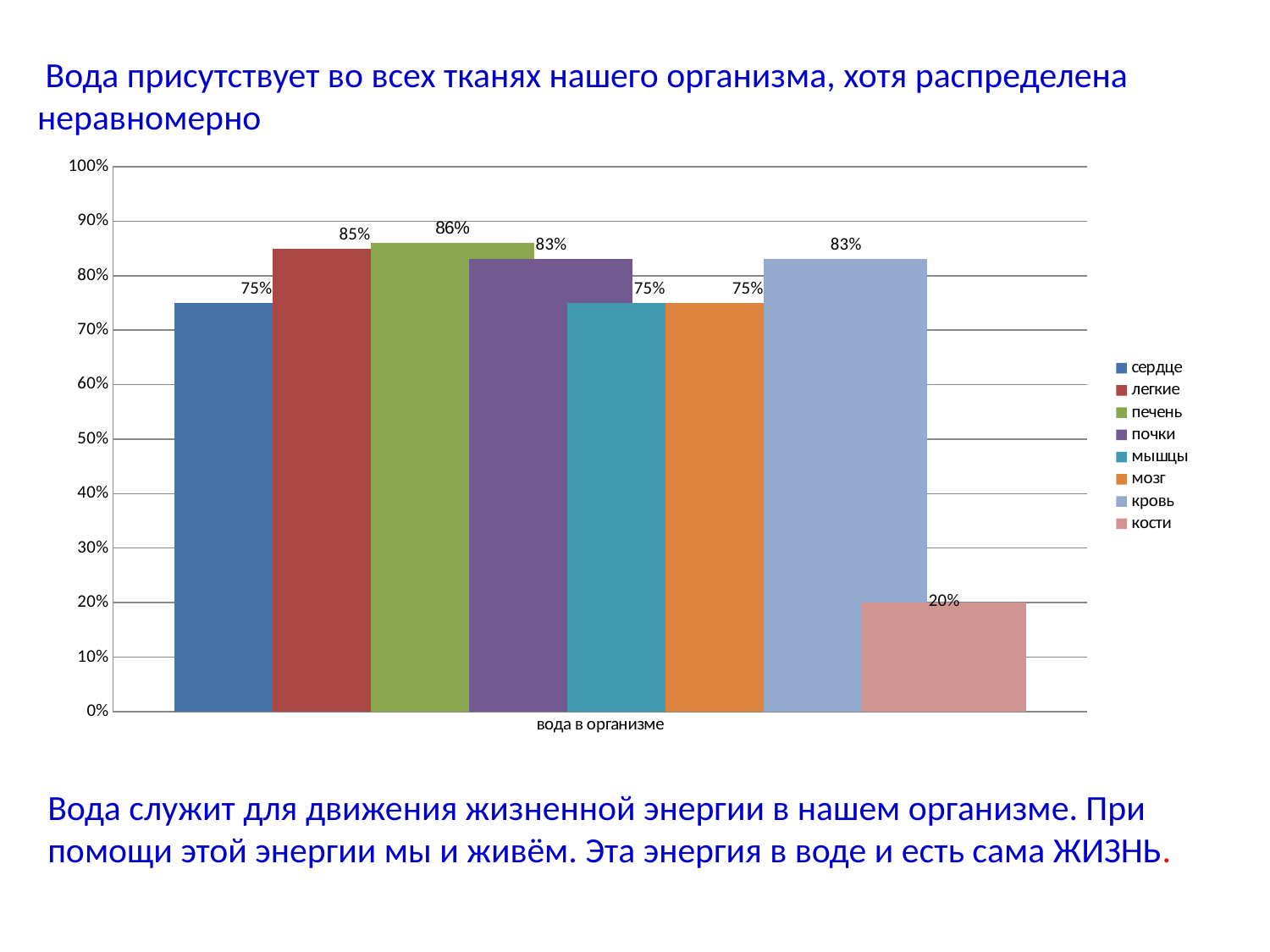
What is the water percentage shown for сердце? 75% What is the difference between the values for легкие and кости? 65% What is the water percentage shown for кости? 20% Which is larger, the value for почки or the value for мышцы? почки What kind of chart is shown on the slide? bar chart What is the water percentage shown for кровь? 83% What is the category label shown on the x axis of the chart? вода в организме Is the value for мозг greater or less than 50%? greater How many series does the legend list? 8 What is the water percentage shown for печень? 86% Which series has the highest value in the chart? печень Which series has the lowest value in the chart? кости